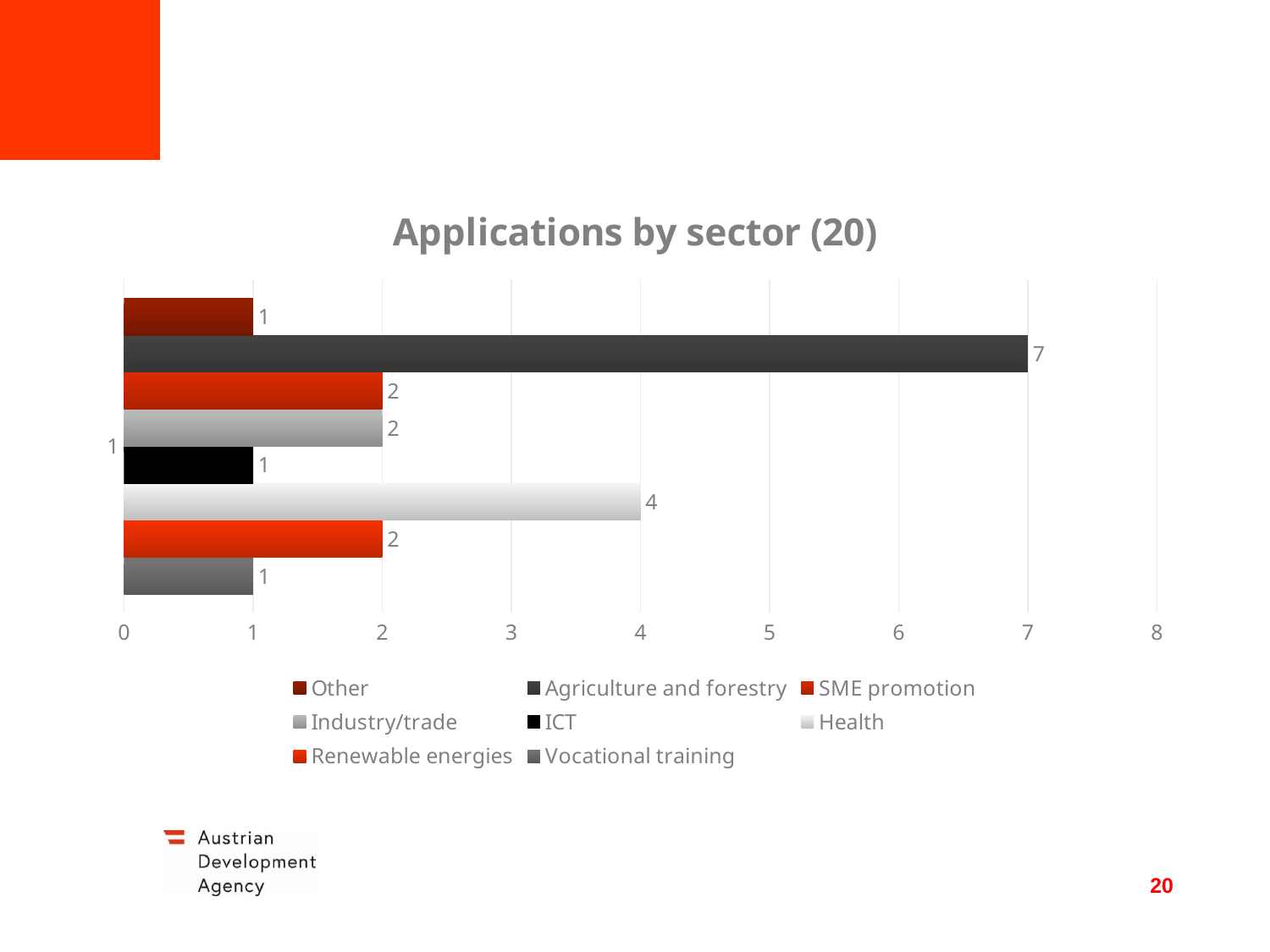
Is the value for Agriculture and forestry greater or less than 5? greater What is the difference between the values for Agriculture and forestry and Health? 3 What is the value for ICT? 1 What is the title of the chart? Applications by sector (20) What is the value for SME promotion? 2 What kind of chart is shown on the slide? bar chart What is the value for Health? 4 Which is larger, the value for Health or the value for Renewable energies? Health How many series does the legend list? 8 How many bars are plotted in the chart? 8 Which sector has the highest number of applications? Agriculture and forestry What is the value for Agriculture and forestry? 7